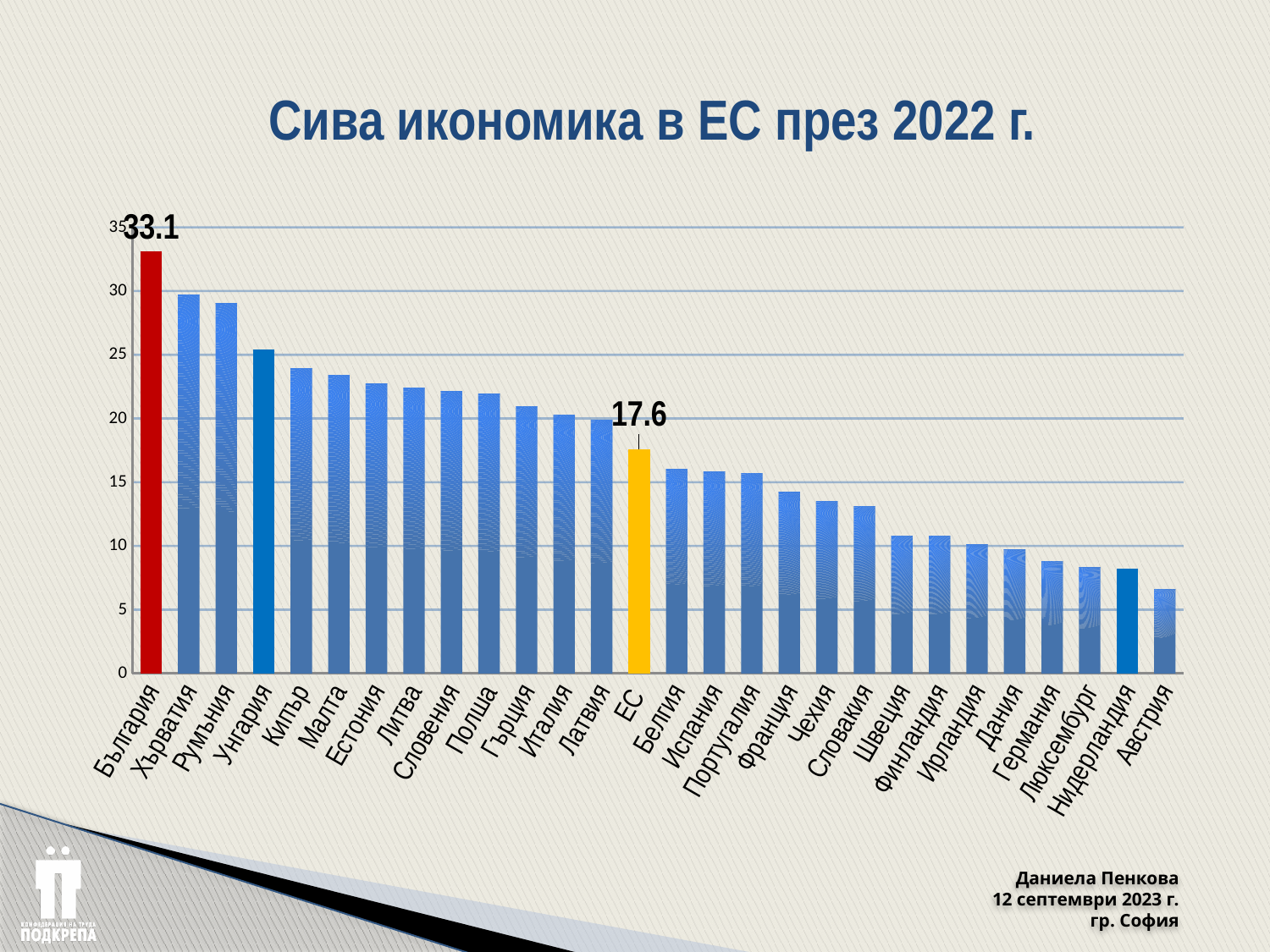
How many categories are shown on the x axis? 28 What is the difference between the values for България and ЕС? 15.5 What kind of chart is shown on the slide? bar chart What is the value for ЕС? 17.6 Do the values rise or fall from left to right along the x axis? fall What is the value for България? 33.1 Which category has the highest value? България Is the value for Австрия greater or less than 10? less Is the value for Белгия greater or less than 15? greater Which category has the lowest value? Австрия Which is larger, the value for Кипър or the value for Латвия? Кипър Is the value for Хърватия greater or less than 25? greater